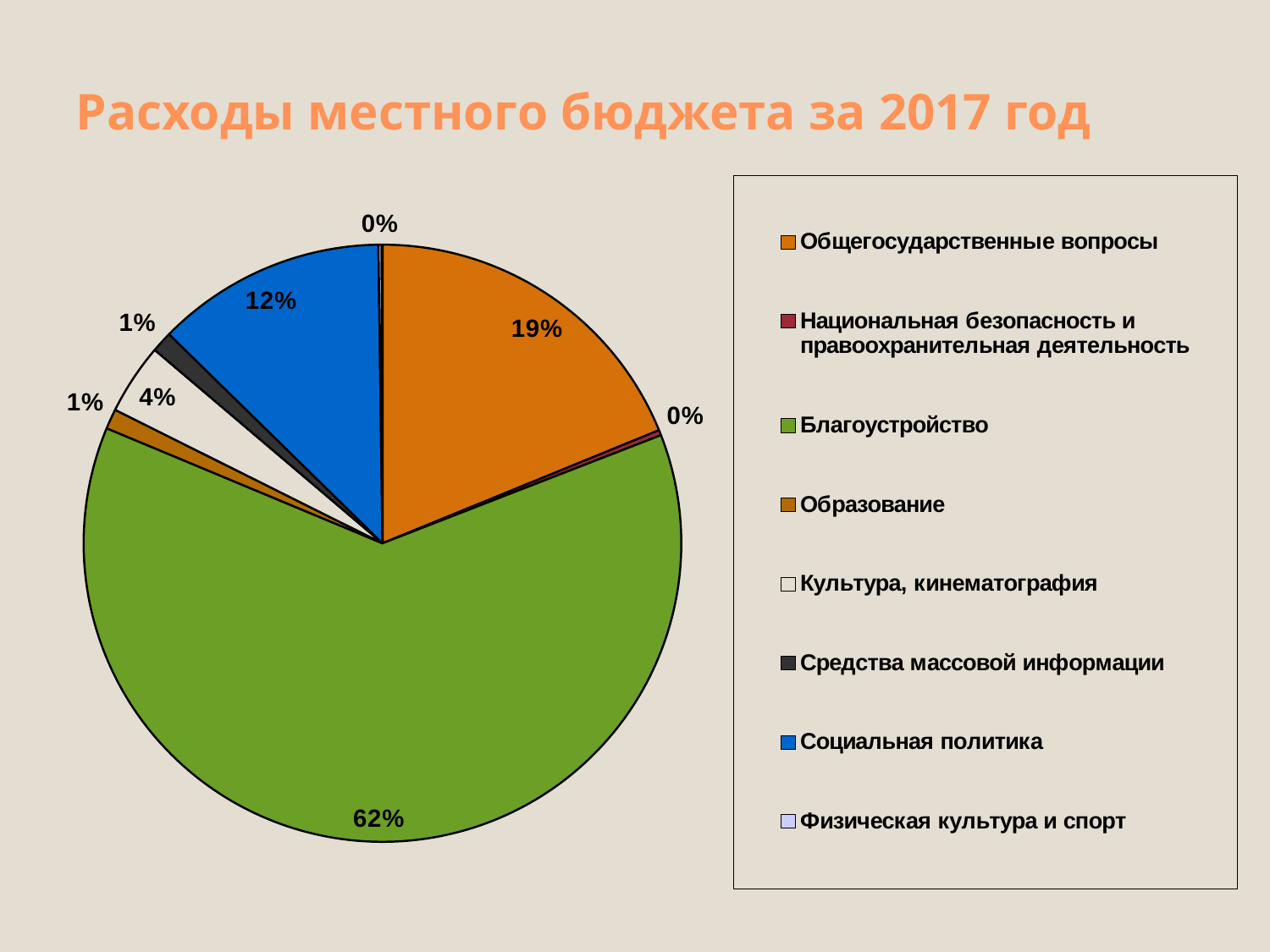
How many categories does the legend list? 8 What share of the pie is Общегосударственные вопросы? 19% What share of the pie is Образование? 1% What is the title of the chart? Расходы местного бюджета за 2017 год What share of the pie is Социальная политика? 12% What share of the pie is Культура, кинематография? 4% Which is larger, the share for Общегосударственные вопросы or the share for Социальная политика? Общегосударственные вопросы What share of the pie is Благоустройство? 62% Which category has the largest share of the pie? Благоустройство What kind of chart is shown on the slide? pie chart What colour is the slice for Социальная политика? blue What is the difference between the share for Благоустройство and the share for Общегосударственные вопросы? 43%